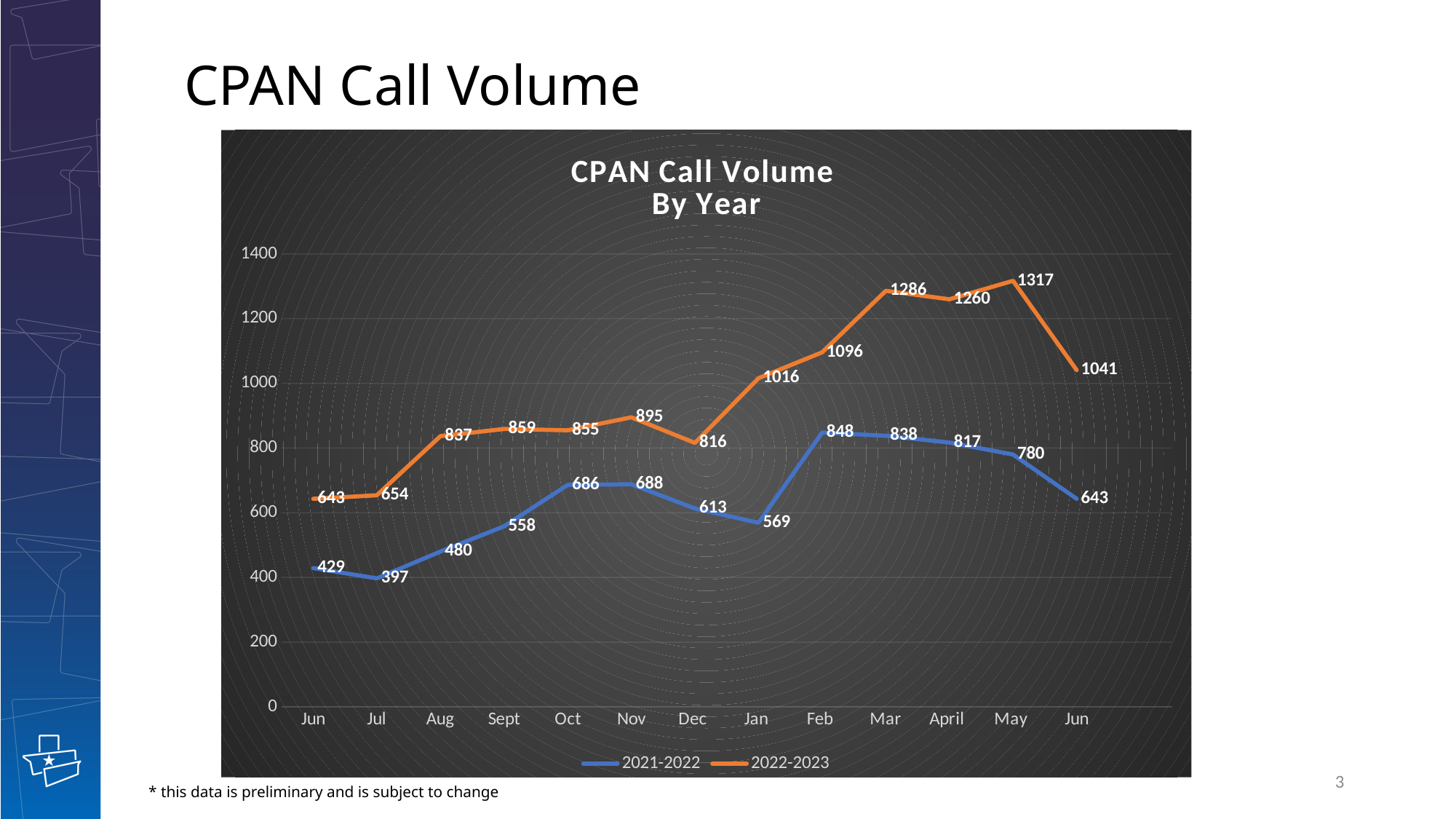
How many months are plotted along the x axis? 13 Does the 2022-2023 series rise or fall from Jan to Mar? rise How many series does the legend list? 2 What is the 2021-2022 call volume for Feb? 848 What is the 2021-2022 call volume for Sept? 558 In which month does the 2022-2023 series reach its highest value? May What is the difference between the 2022-2023 and 2021-2022 values for May? 537 What kind of chart is shown on the slide? line chart What is the difference between the 2022-2023 and 2021-2022 values for Dec? 203 Which is larger: the 2022-2023 value for Jan or the 2021-2022 value for Feb? 2022-2023 value for Jan What is the 2022-2023 call volume for Mar? 1286 In which month does the 2021-2022 series have its lowest value? Jul